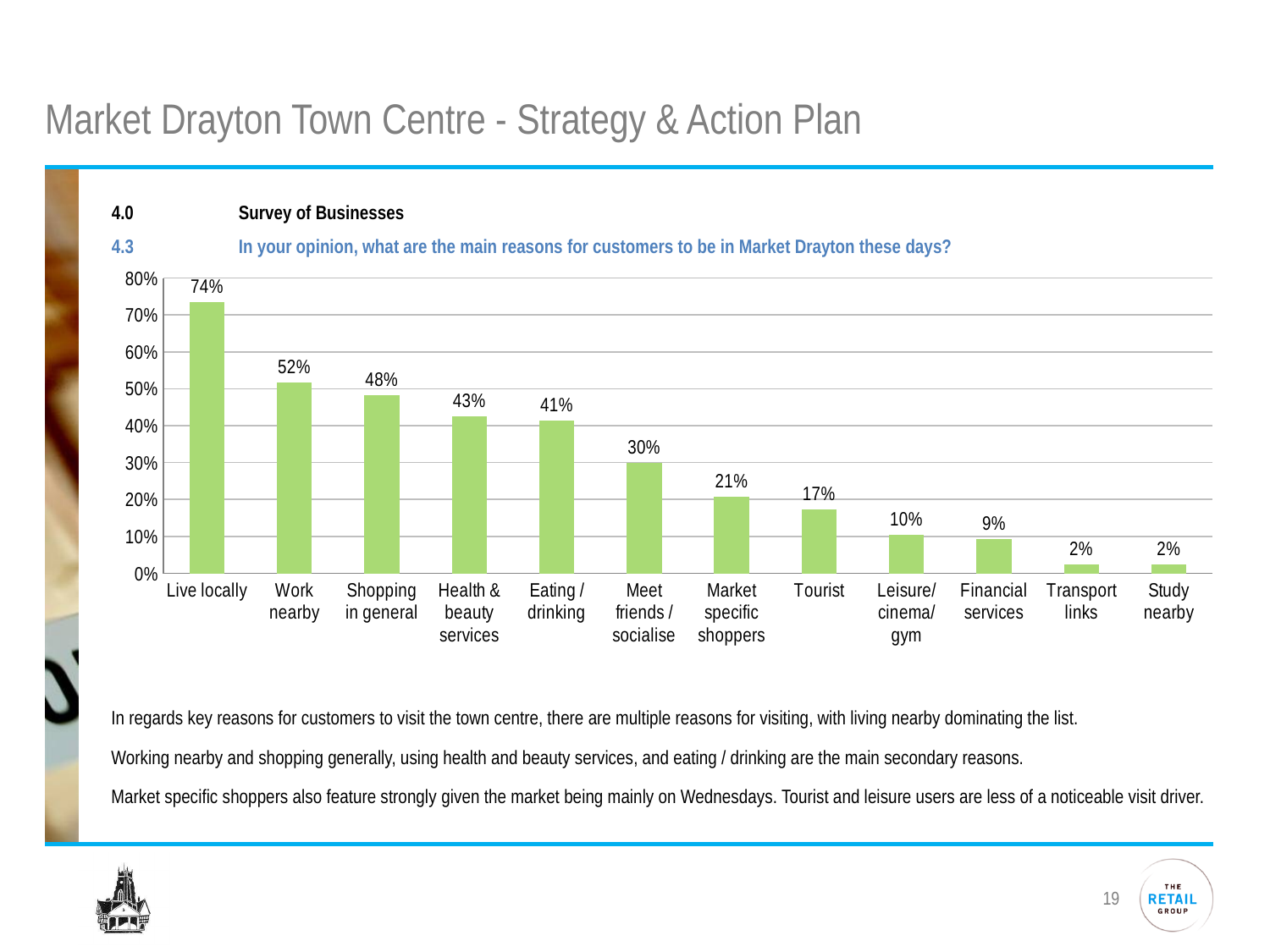
What is the difference between the values for 'Work nearby' and 'Shopping in general'? 4% What kind of chart is shown on the slide? Bar chart Which category has the highest value in the chart? Live locally What is the difference between the values for 'Live locally' and 'Work nearby'? 22% Do the values rise or fall moving from left to right along the x axis? Fall How many categories are shown on the x axis of the chart? 12 Which categories share the lowest value in the chart? Transport links and Study nearby Is the value for 'Tourist' greater or less than 20%? less What is the value shown for 'Financial services'? 9% What percentage of businesses cited 'Live locally' as a main reason for customers to be in Market Drayton? 74% Which is larger, the value for 'Eating / drinking' or the value for 'Meet friends / socialise'? Eating / drinking What is the value shown for 'Market specific shoppers'? 21%